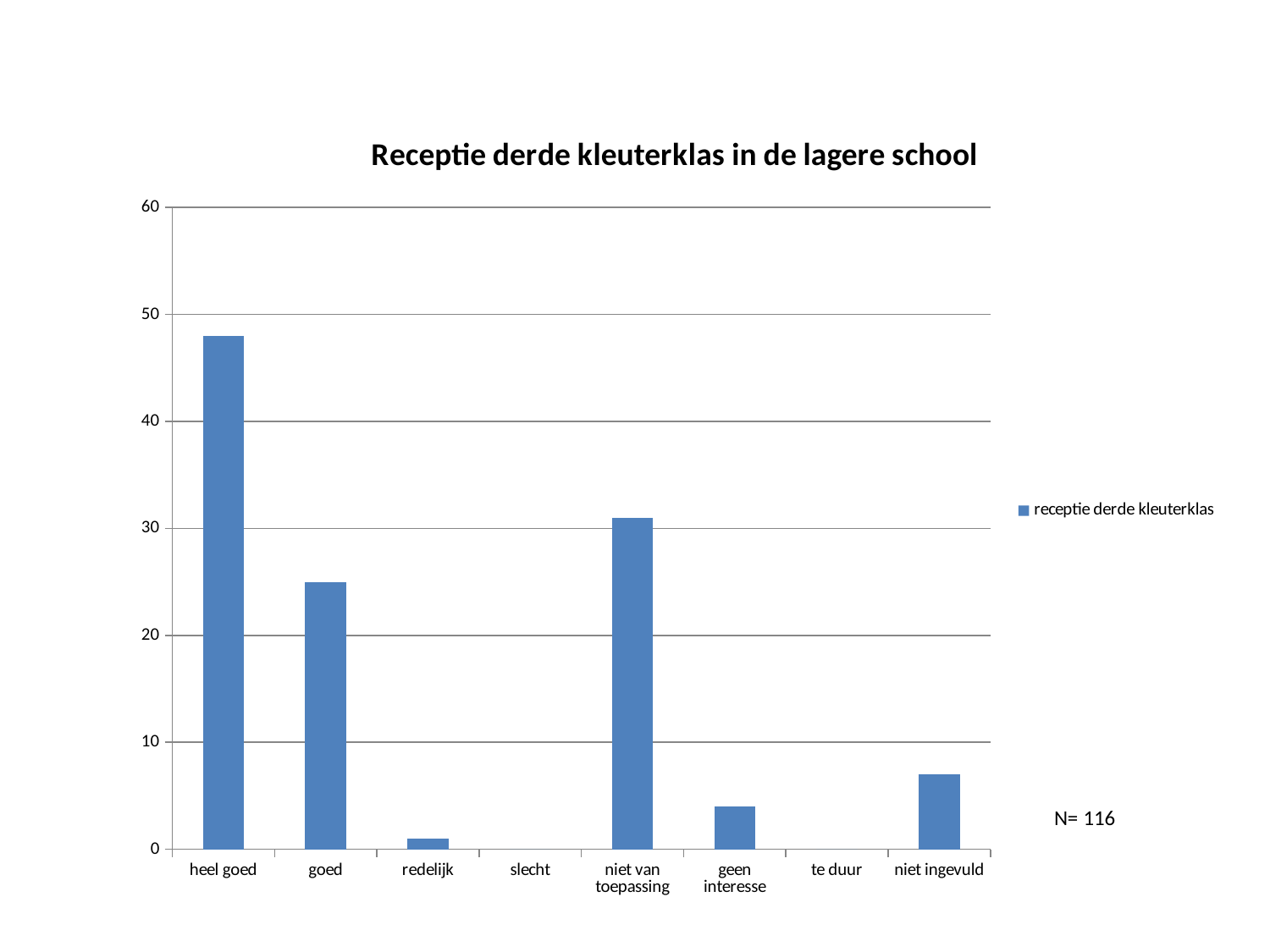
Which category has the highest value? heel goed Is the value for heel goed greater or less than 40? greater What is the title of the chart? Receptie derde kleuterklas in de lagere school How many series does the legend list? 1 Is the value for niet van toepassing greater or less than 30? greater Which is larger, the value for geen interesse or the value for niet ingevuld? niet ingevuld Is the value for niet ingevuld greater or less than 10? less What kind of chart is shown on the slide? bar chart How many categories are shown on the x axis? 8 What is the series name shown in the legend? receptie derde kleuterklas Which is larger, the value for goed or the value for niet van toepassing? niet van toepassing